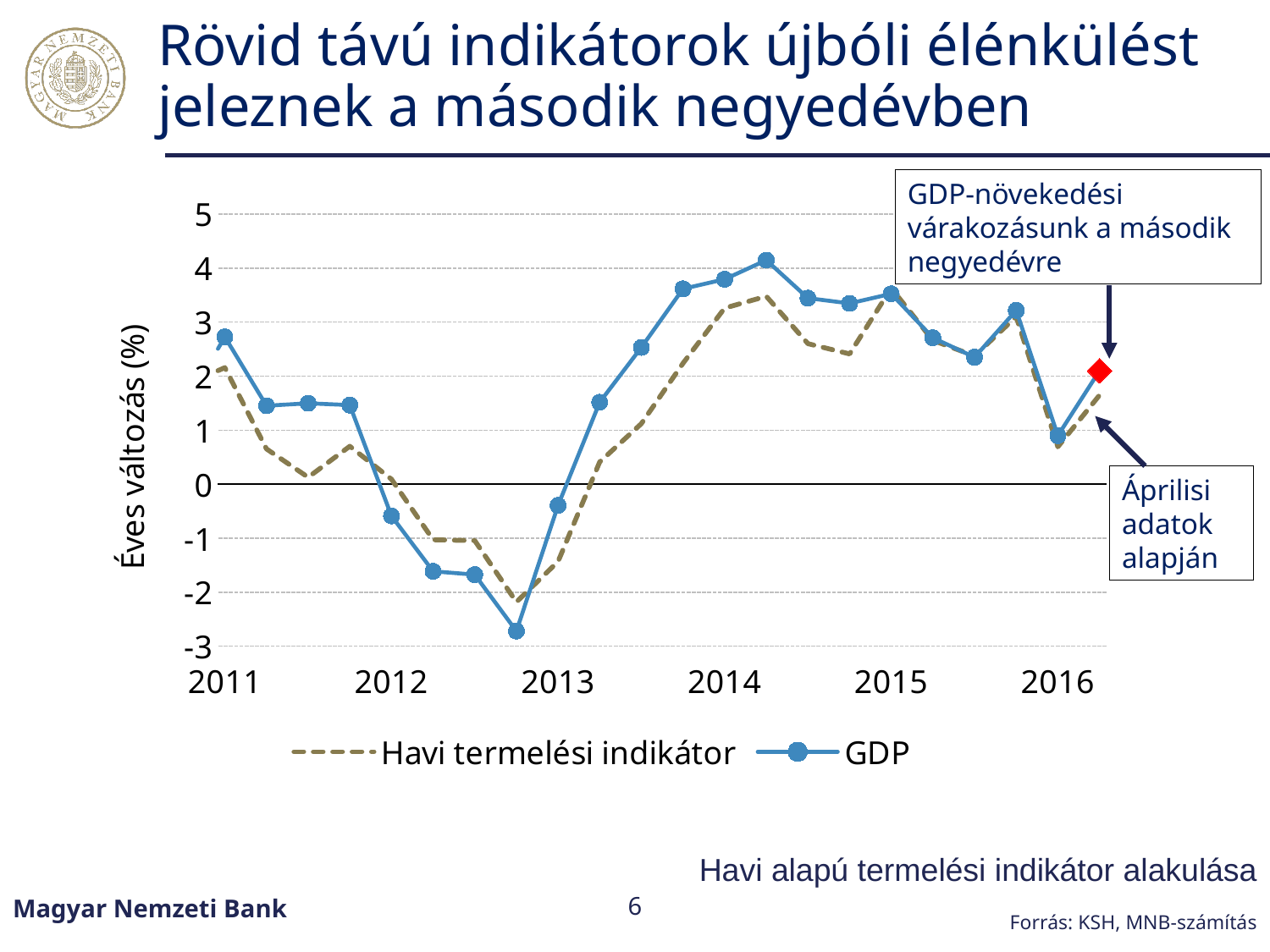
What are the two series named in the legend? Havi termelési indikátor and GDP Which series is higher at the start of 2013, GDP or Havi termelési indikátor? GDP Is the highest GDP value, reached in early 2014, greater or less than 4? greater How many series does the legend list? 2 In which year does the GDP series reach its lowest point? 2012 What kind of chart is shown on the slide? line chart Does the GDP series rise or fall between the end of 2012 and the start of 2014? rise What is the label of the vertical axis? Éves változás (%) Is the GDP value at the start of 2011 greater or less than 2? greater Is the GDP value at the start of 2016 greater or less than 2? less In which year does the GDP series reach its highest point? 2014